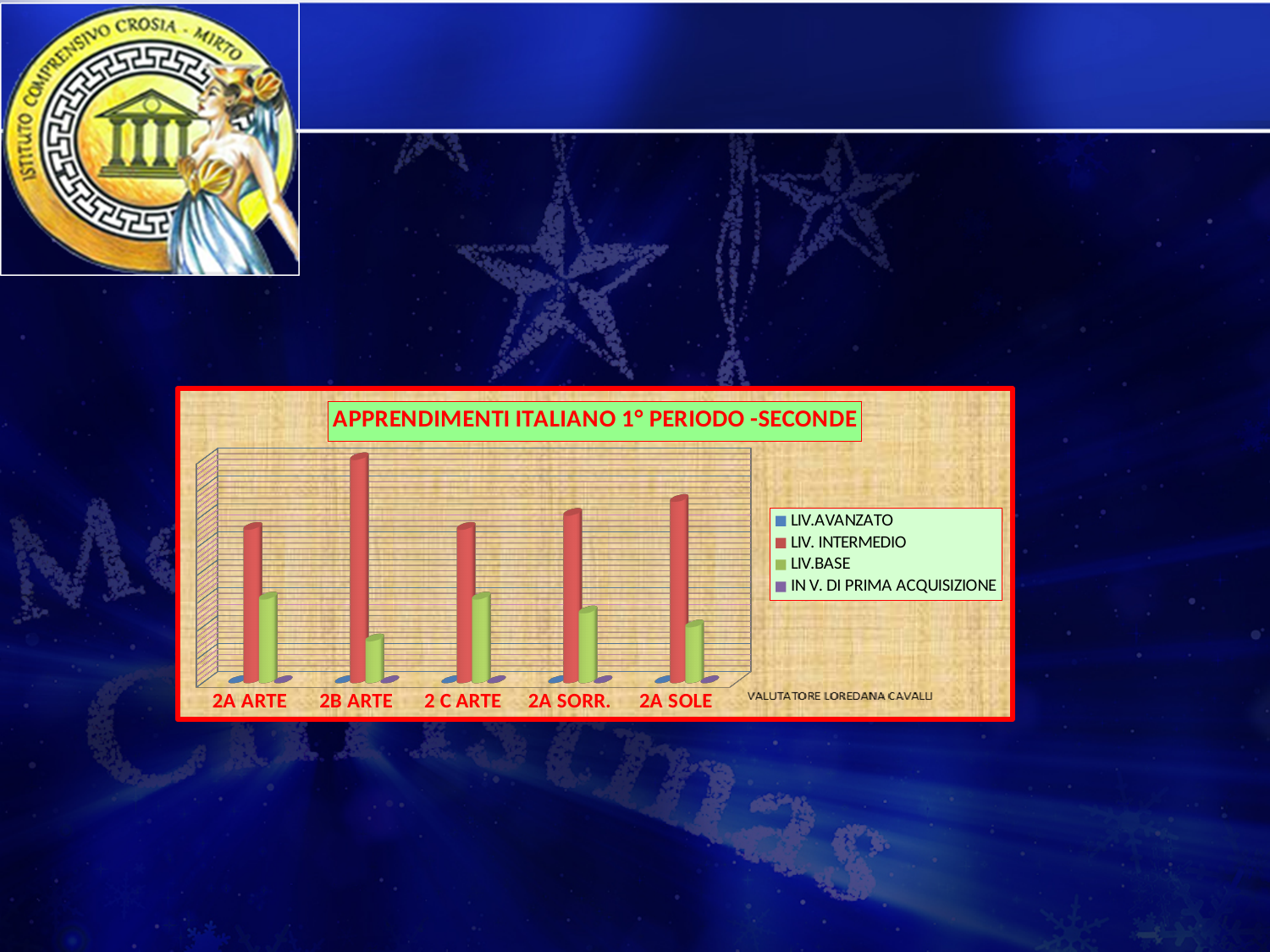
Which is larger, the LIV.BASE bar for 2A SORR. or for 2A SOLE? 2A SORR. Which is larger, the LIV. INTERMEDIO bar for 2B ARTE or for 2A SOLE? 2B ARTE Which class has the lowest LIV.BASE bar? 2B ARTE For 2A ARTE, which series has the taller bar, LIV. INTERMEDIO or LIV.BASE? LIV. INTERMEDIO Which class has the highest LIV. INTERMEDIO bar? 2B ARTE How many classes (categories) are shown on the x axis of the chart? 5 How many series does the chart's legend list? 4 What colour represents LIV.BASE in the chart's legend? green What is the title of the chart? APPRENDIMENTI ITALIANO 1° PERIODO -SECONDE What kind of chart is shown on the slide? bar chart